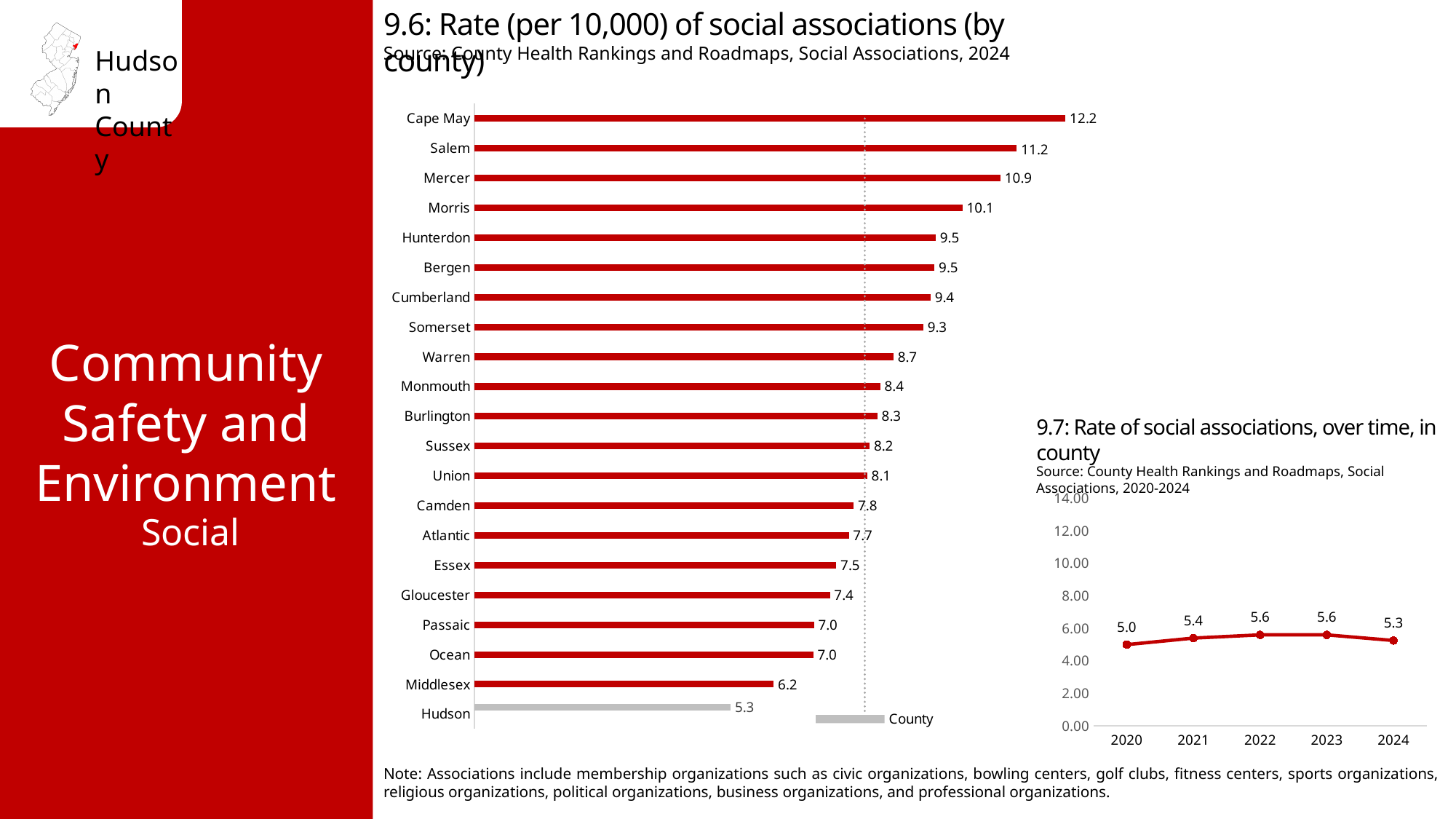
In chart 9.6 (rate of social associations by county), what is the value for Middlesex? 6.2 In chart 9.7 (rate of social associations over time), what is the value for 2022? 5.6 In chart 9.6 (rate of social associations by county), what is the value for Hudson? 5.3 In chart 9.7 (rate of social associations over time), how many years are plotted? 5 In chart 9.6 (rate of social associations by county), which county has the highest rate? Cape May What kind of chart is chart 9.6 (rate of social associations by county)? Bar chart In chart 9.7 (rate of social associations over time), which year has the lowest value? 2020 In chart 9.6 (rate of social associations by county), how many counties are shown? 21 In chart 9.7 (rate of social associations over time), what is the difference between 2021 and 2024? 0.1 In chart 9.6 (rate of social associations by county), which county has the lowest rate? Hudson In chart 9.6 (rate of social associations by county), which has a higher rate, Mercer or Morris? Mercer In chart 9.6 (rate of social associations by county), what is the difference between Cape May and Hudson? 6.9